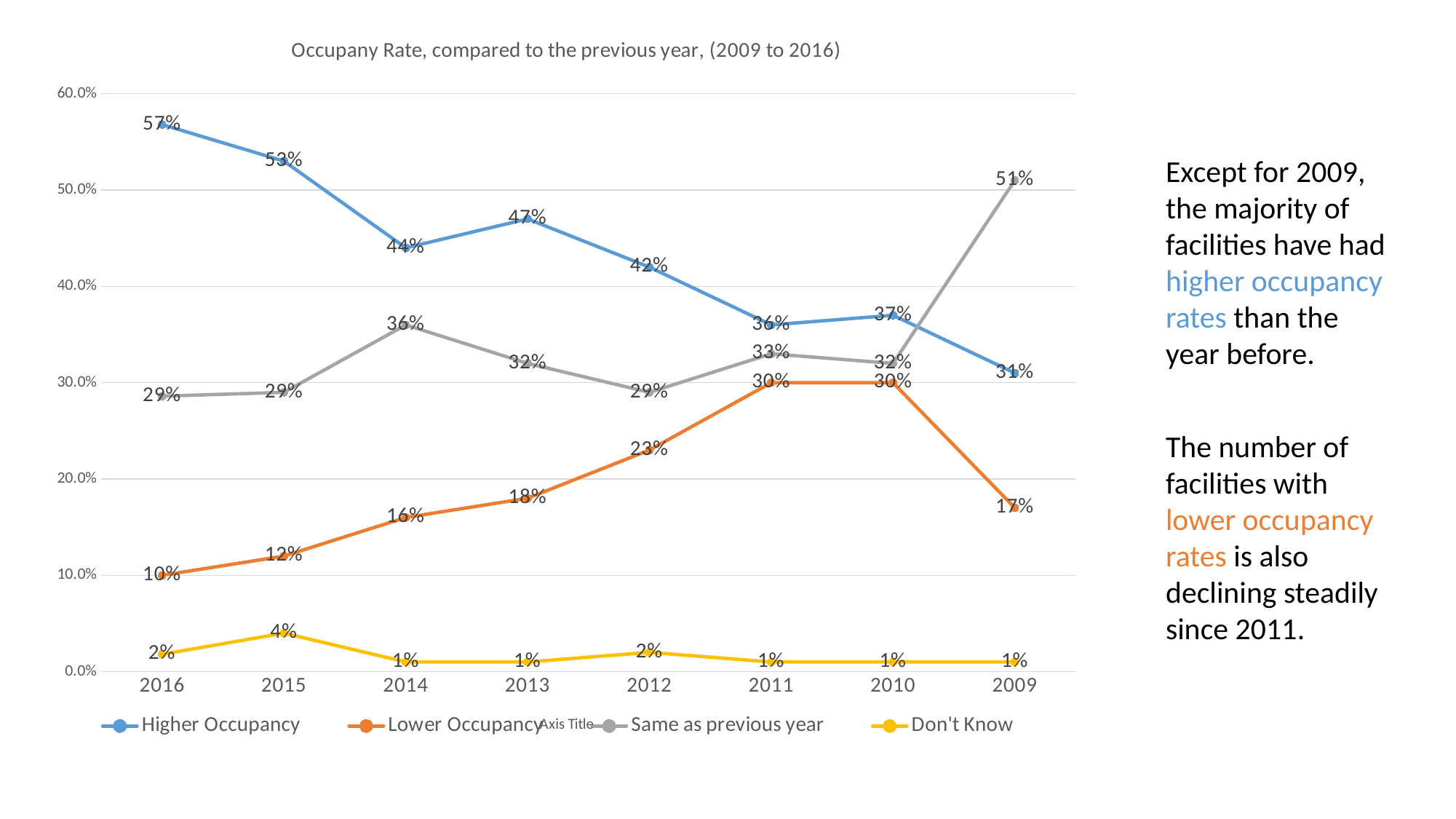
In which year is the Higher Occupancy series at its highest? 2016 What is the value for Higher Occupancy in 2016? 57% How many years are shown on the x axis? 8 In which year is the Lower Occupancy series at its lowest? 2016 What is the value for Lower Occupancy in 2012? 23% What is the title of the chart? Occupany Rate, compared to the previous year, (2009 to 2016) What kind of chart is shown on the slide? Line chart Which is larger in 2009: Higher Occupancy or Same as previous year? Same as previous year What is the value for Don't Know in 2015? 4% What is the difference between Higher Occupancy and Lower Occupancy in 2016? 47% How many series does the legend list? 4 What is the value for Same as previous year in 2009? 51%